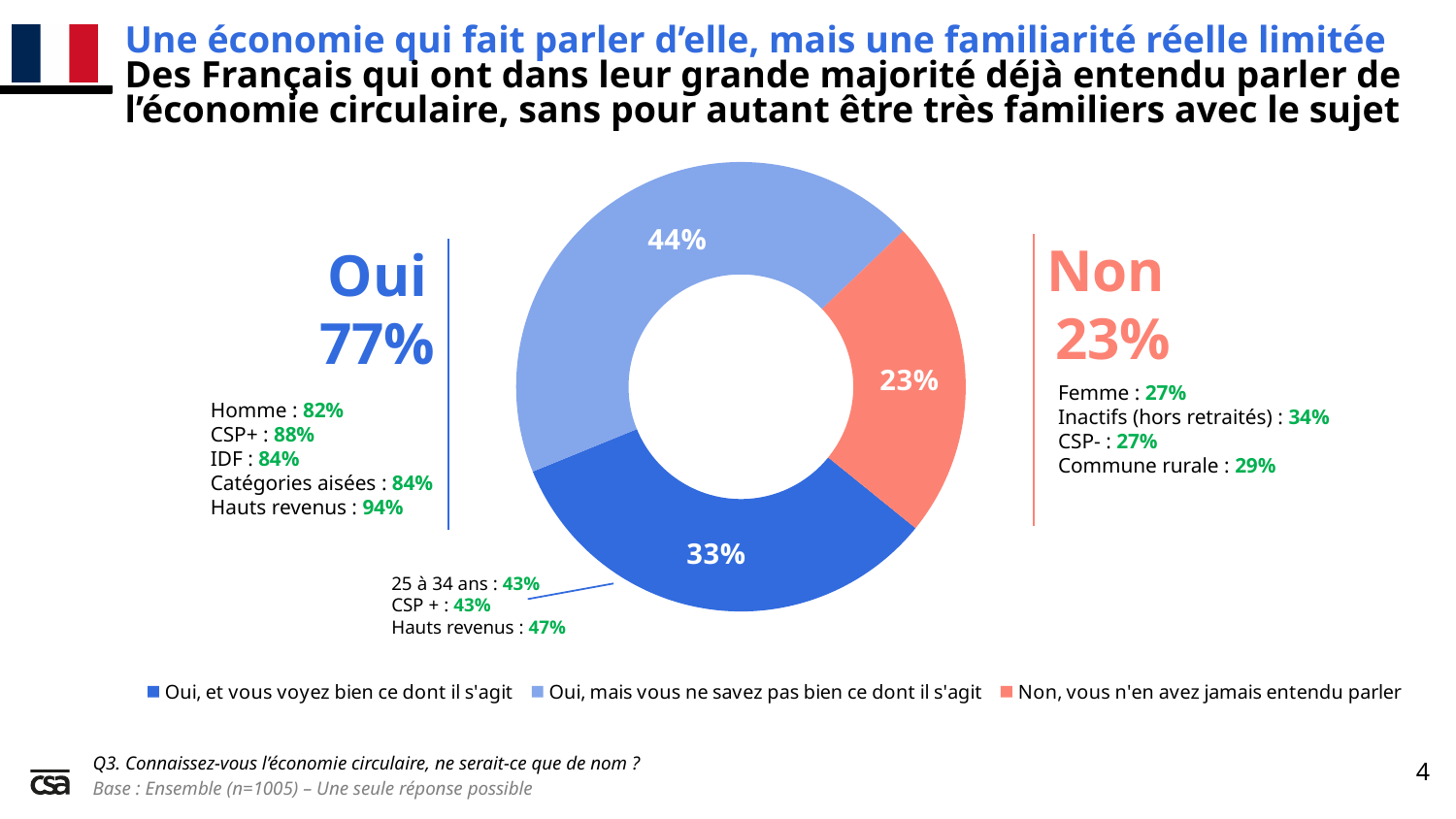
Which response has the smallest share of the pie? Non, vous n'en avez jamais entendu parler What kind of chart is shown on the slide? Pie chart (donut) What colour is the slice for "Non, vous n'en avez jamais entendu parler"? Salmon/light red What percentage of respondents answered "Oui, mais vous ne savez pas bien ce dont il s'agit"? 44% What percentage of respondents answered "Oui, et vous voyez bien ce dont il s'agit"? 33% Which is larger: the share for "Oui, et vous voyez bien ce dont il s'agit" or the share for "Non, vous n'en avez jamais entendu parler"? Oui, et vous voyez bien ce dont il s'agit What is the combined share of the two "Oui" slices? 77% What percentage of respondents answered "Non, vous n'en avez jamais entendu parler"? 23% How many entries does the legend list? 3 What is the difference in percentage points between the "Oui, mais vous ne savez pas bien ce dont il s'agit" slice and the "Non, vous n'en avez jamais entendu parler" slice? 21 percentage points How many slices does the pie chart have? 3 Which response has the largest share of the pie? Oui, mais vous ne savez pas bien ce dont il s'agit